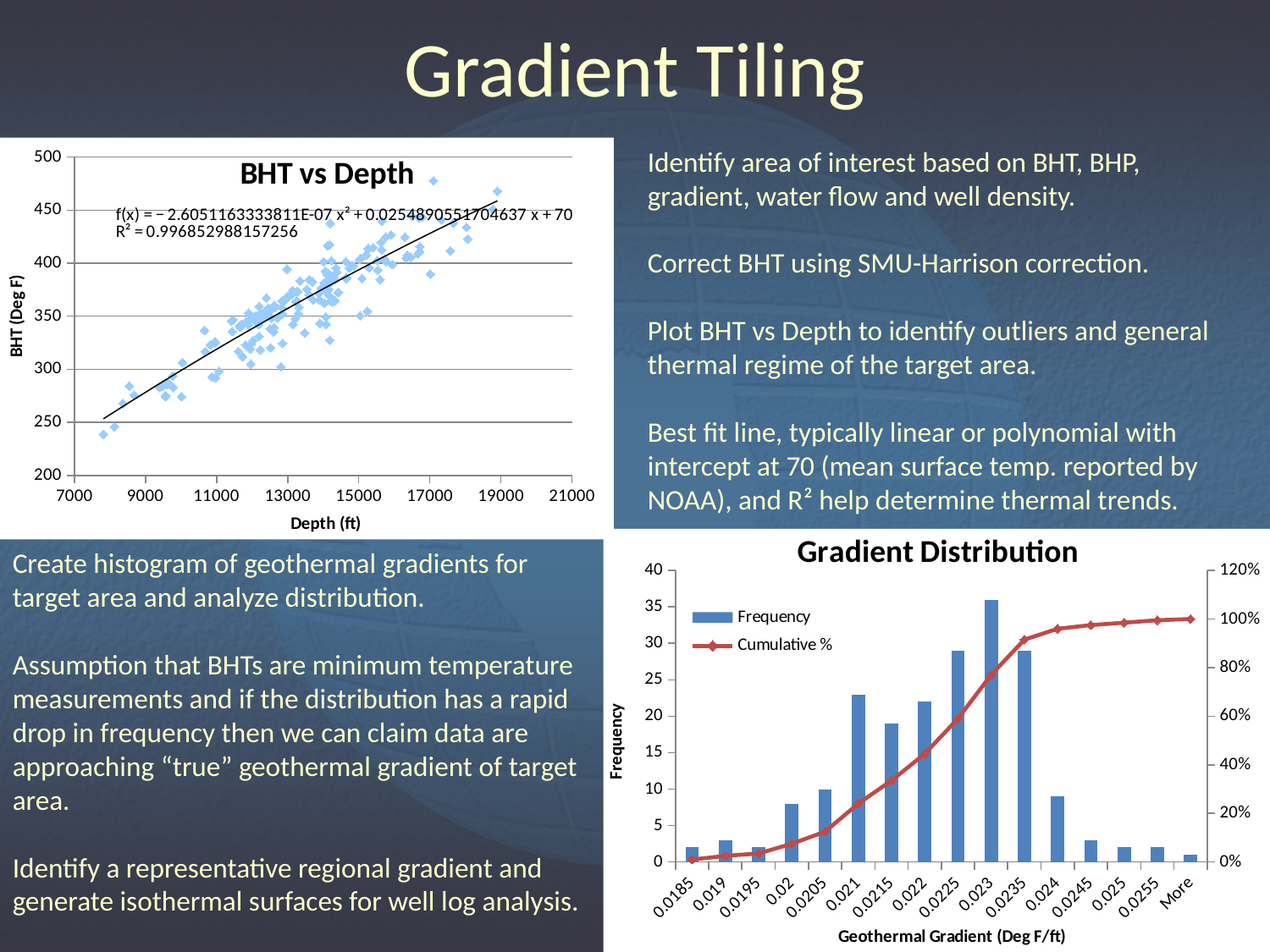
In the Gradient Distribution chart, does the Cumulative % line rise or fall from left to right along the x axis? Rise In the Gradient Distribution chart, which gradient category has the highest frequency? 0.023 In the Gradient Distribution chart, is the frequency for 0.021 greater or less than 20? greater What kind of chart is the BHT vs Depth chart on the left of the slide? Scatter plot In the Gradient Distribution chart, what kind of chart is used to show the Frequency series? Bar chart In the Gradient Distribution chart, which has the higher frequency, 0.023 or 0.0235? 0.023 In the Gradient Distribution chart, how many gradient categories are shown on the x axis? 16 In the BHT vs Depth chart, what is the label of the x axis? Depth (ft) In the BHT vs Depth chart, what is the R² value printed on the chart? 0.996852988157256 In the Gradient Distribution chart, is the frequency for 0.023 greater or less than 30? greater In the Gradient Distribution chart, how many series does the legend list? 2 In the Gradient Distribution chart, is the frequency for 0.0205 greater or less than 15? less